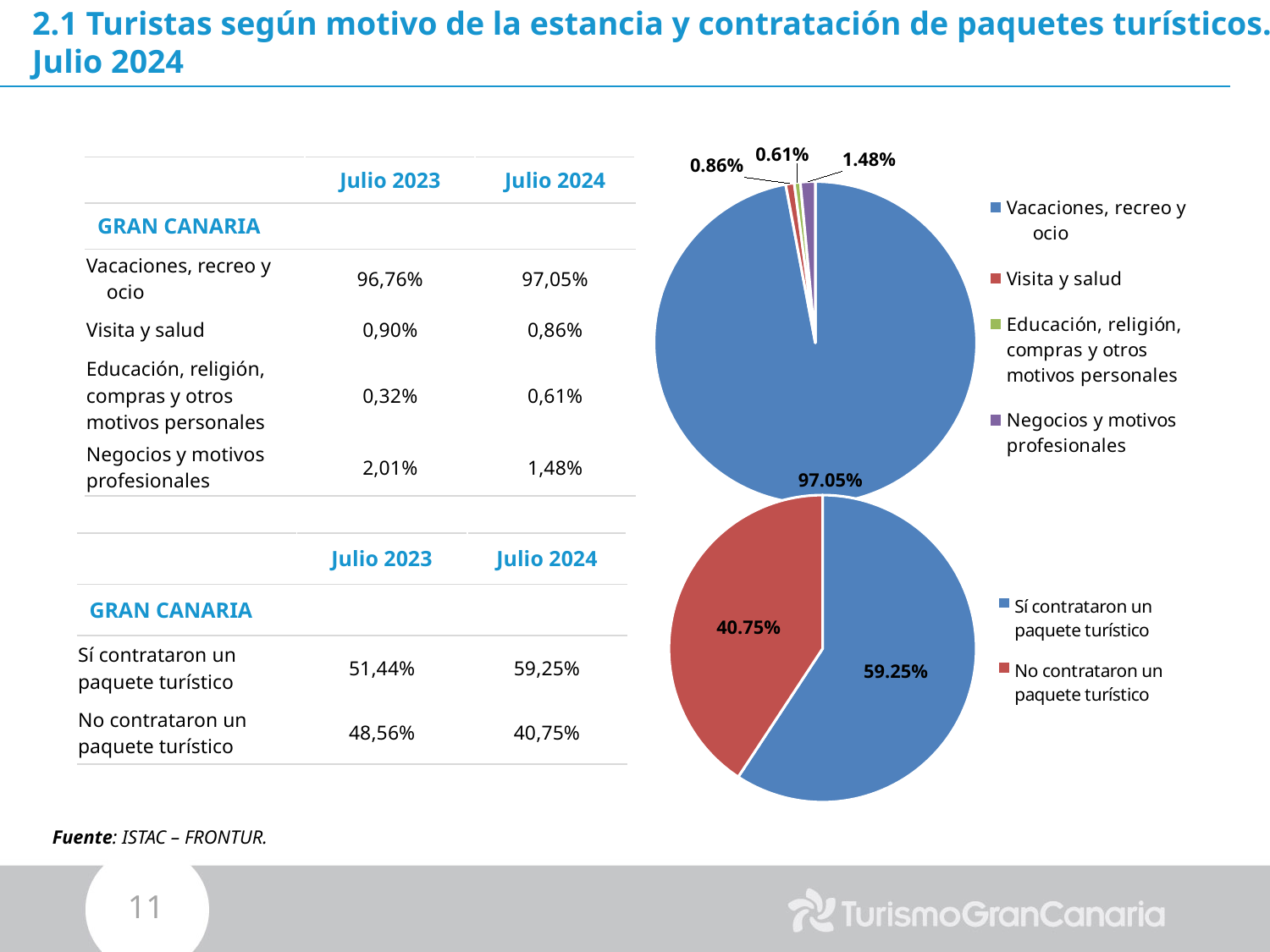
In the top pie chart, which category has the smallest slice? Educación, religión, compras y otros motivos personales In the bottom pie chart, what is the difference between the two slices? 18.50% How many categories does the legend of the top pie chart list? 4 In the top pie chart, which category has the largest slice? Vacaciones, recreo y ocio In the bottom pie chart, which is larger: Sí contrataron un paquete turístico or No contrataron un paquete turístico? Sí contrataron un paquete turístico In the top pie chart, what is the value for Vacaciones, recreo y ocio? 97.05% In the top pie chart, what is the value for Negocios y motivos profesionales? 1.48% In the bottom pie chart, what is the value for Sí contrataron un paquete turístico? 59.25% In the top pie chart, what is the difference between the values for Negocios y motivos profesionales and Visita y salud? 0.62% What kind of chart is the top chart on the slide? pie chart In the bottom pie chart, what is the value for No contrataron un paquete turístico? 40.75% In the top pie chart, what is the value for Visita y salud? 0.86%